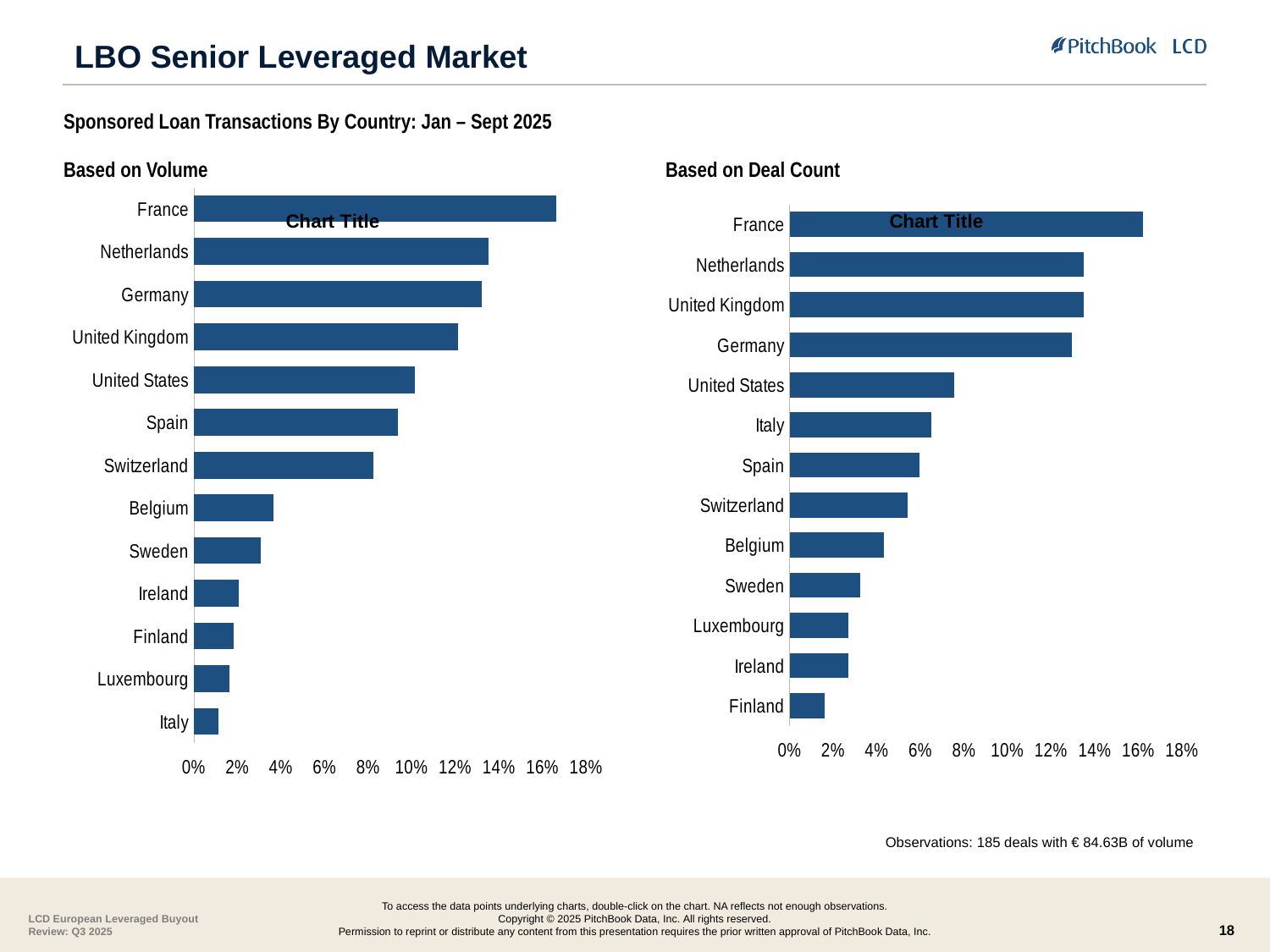
In the 'Based on Deal Count' chart, which is larger, the value for Italy or the value for Sweden? Italy In the 'Based on Deal Count' chart, which country has the lowest share? Finland In the 'Based on Volume' chart, which is larger, the value for United States or the value for Belgium? United States In the 'Based on Volume' chart, is the value for Switzerland greater or less than 10%? less In the 'Based on Deal Count' chart, is the value for United States greater or less than 8%? less What is the highest tick value shown on the x axis of the 'Based on Deal Count' chart? 18% What kind of chart is the 'Based on Volume' chart? bar chart In the 'Based on Volume' chart, which country has the lowest share? Italy In the 'Based on Volume' chart, which country has the highest share? France In the 'Based on Deal Count' chart, which country has the highest share? France How many countries are shown in the 'Based on Volume' chart? 13 In the 'Based on Volume' chart, is the value for France greater or less than 16%? greater